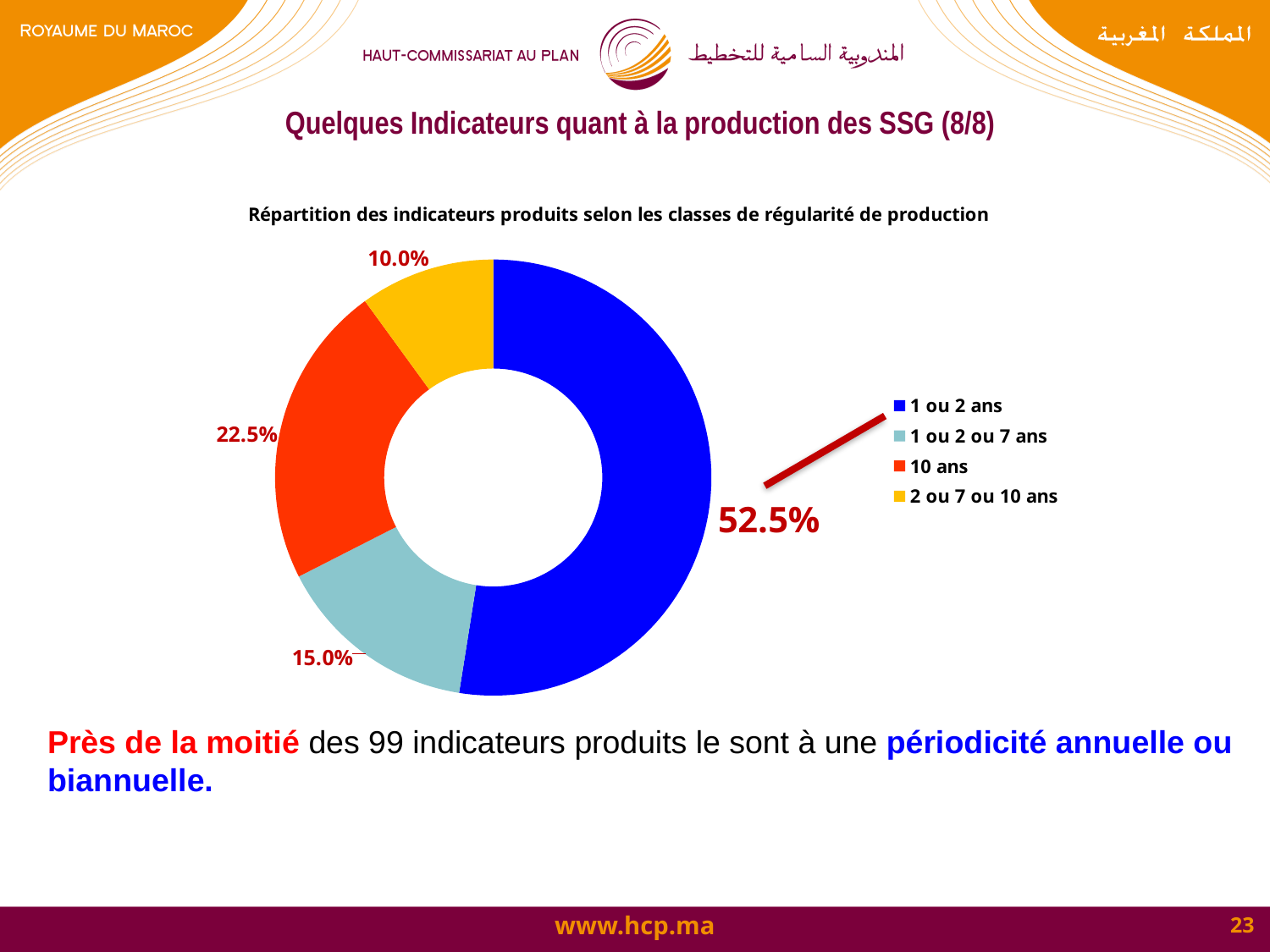
Which regularity class has the largest share of indicators? 1 ou 2 ans What share of the indicators falls in the 10 ans class? 22.5% How many regularity classes are shown in the chart? 4 What type of chart is used to show the distribution of indicators by regularity class? Doughnut (pie) chart What is the difference in percentage points between the 1 ou 2 ans share and the 10 ans share? 30 percentage points Which class has a larger share: 10 ans or 1 ou 2 ou 7 ans? 10 ans What share of the indicators falls in the 2 ou 7 ou 10 ans class? 10.0% Which colour represents the 10 ans class in the chart? Red (orange-red) Which regularity class has the smallest share of indicators? 2 ou 7 ou 10 ans What is the title of the chart? Répartition des indicateurs produits selon les classes de régularité de production What share of the indicators is produced every 1 ou 2 ans? 52.5% What share of the indicators falls in the 1 ou 2 ou 7 ans class? 15.0%